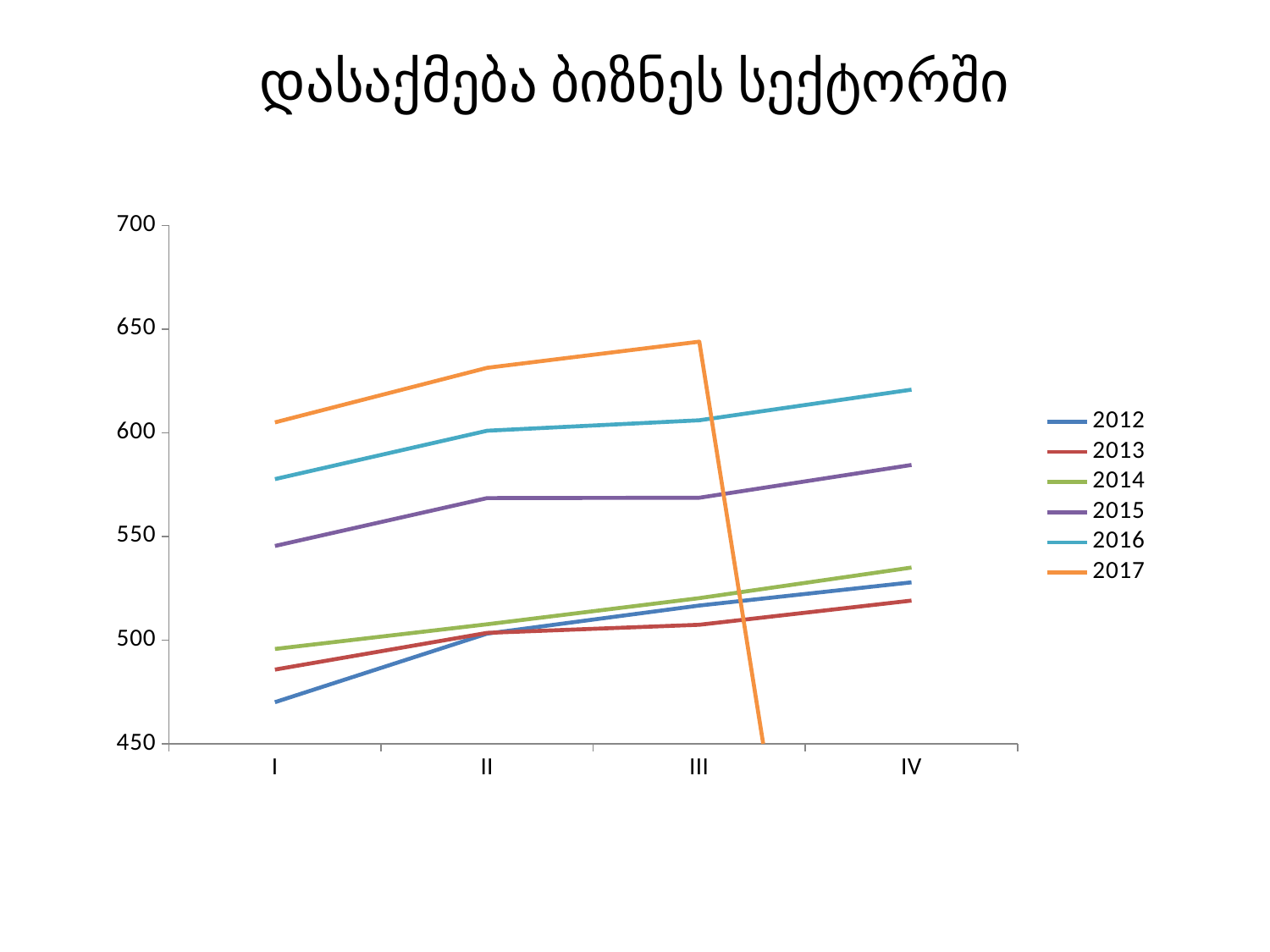
What kind of chart is shown on the slide? line chart Is the value for 2017 at III greater or less than 600? greater How many series does the legend list? 6 Which series has the lowest value at I? 2012 How many categories are shown on the x axis? 4 Is the value for 2015 at IV greater or less than 600? less At IV, which is larger: the value for 2016 or the value for 2015? 2016 Is the value for 2013 at I greater or less than 500? less Does the 2016 line rise or fall from I to IV? rise What is the title of the chart? დასაქმება ბიზნეს სექტორში Which series has the highest value at II? 2017